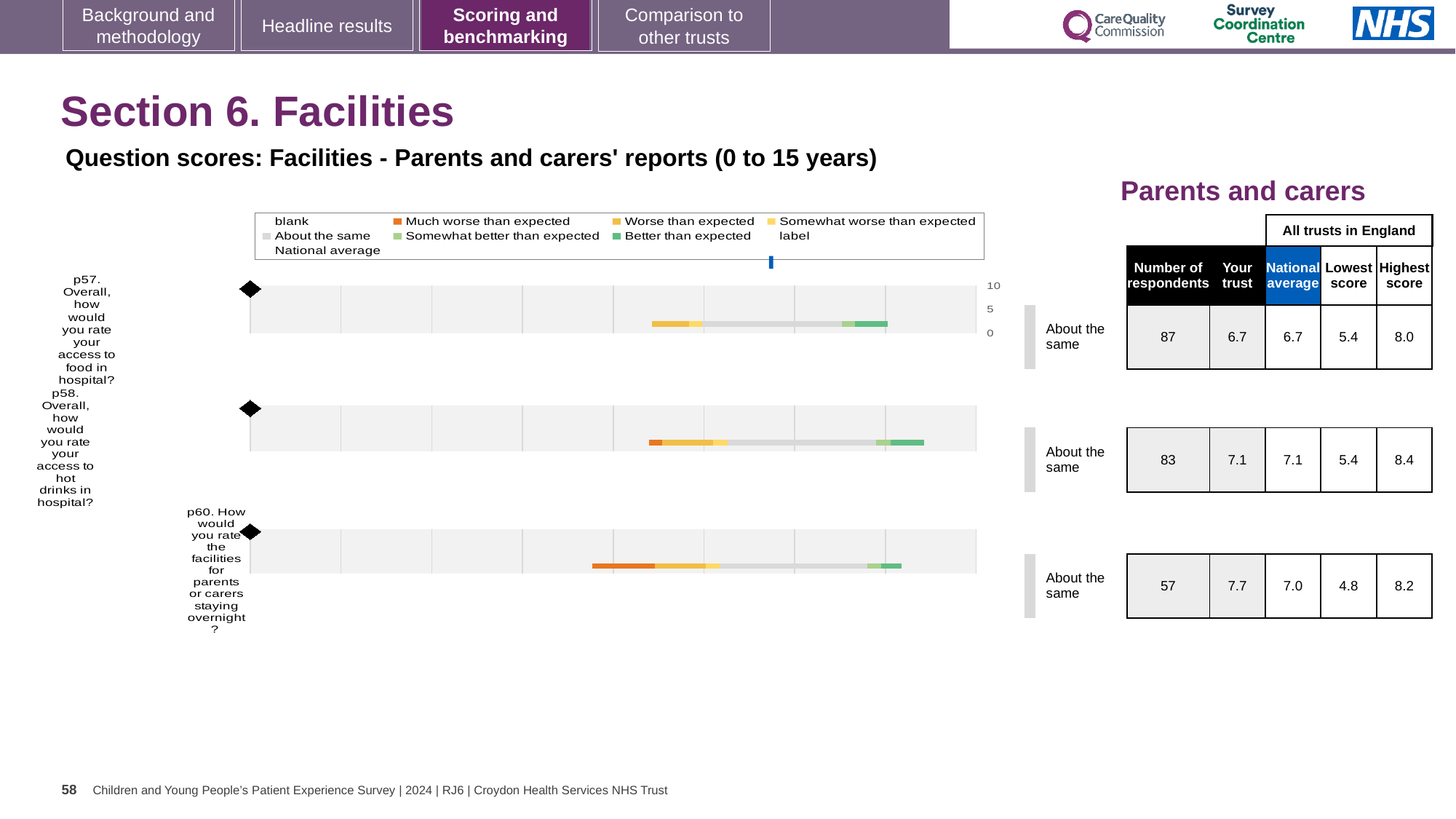
What kind of chart is used to show the question scores on this slide? bar chart What benchmark category label is shown next to each of the three bars? About the same Which colour does the legend use for 'Better than expected'? green What is the highest value shown on the chart's score axis? 10 For p60, what is the difference between the highest score (8.2) and the lowest score (4.8) across all trusts in England? 3.4 In the table beside the chart, what is the national average for p60 (facilities for parents or carers staying overnight)? 7.0 Which of the three questions has the highest 'Your trust' score? p60 In the table beside the chart, what is the 'Your trust' score for p57 (access to food in hospital)? 6.7 In the table beside the chart, how many respondents answered p58 (access to hot drinks in hospital)? 83 How many survey questions are plotted in the chart? 3 For p60, which is larger: the 'Your trust' score or the national average? Your trust In the table beside the chart, what is the lowest score across all trusts in England for p57? 5.4